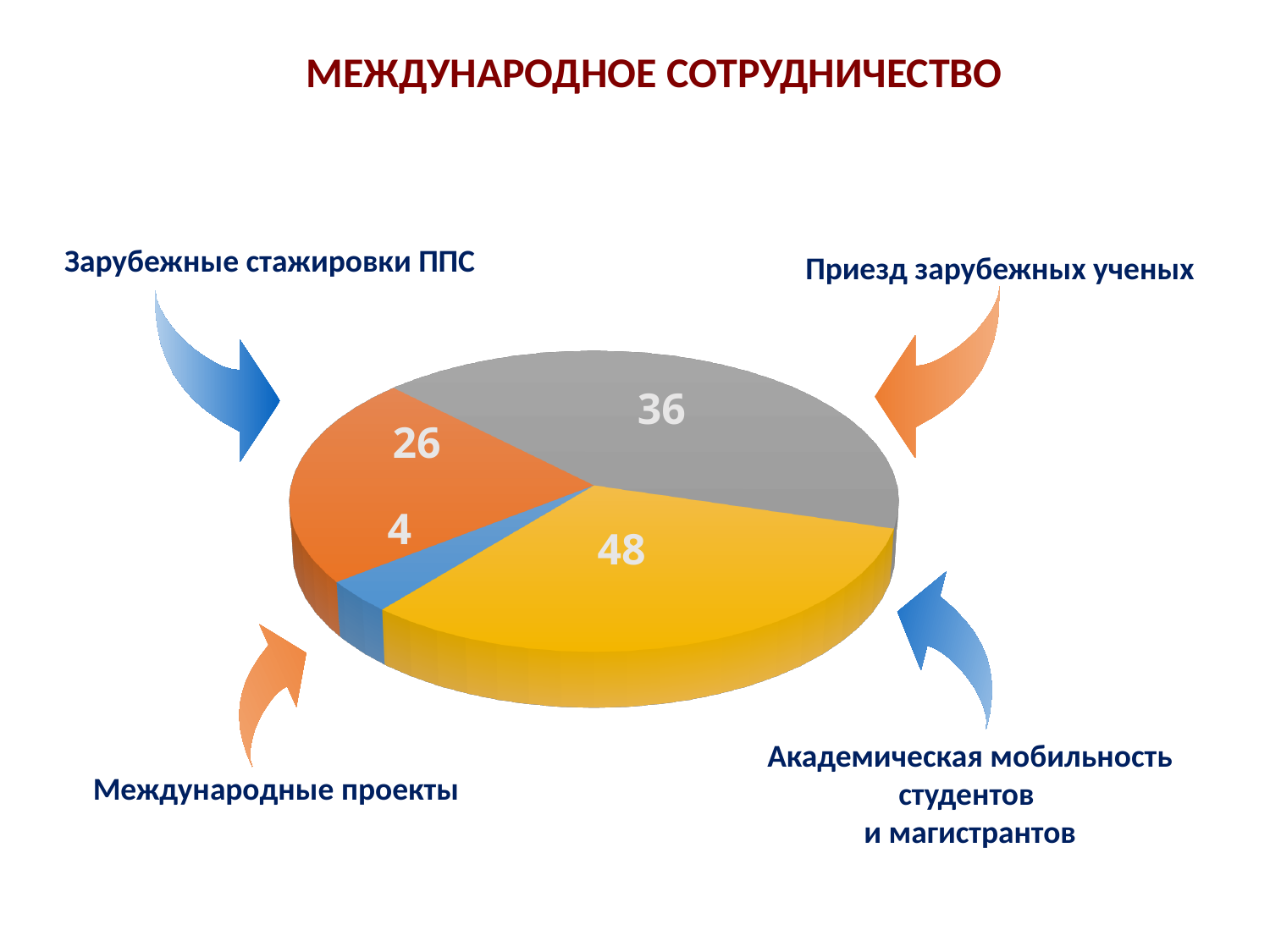
What is the value of the slice for Зарубежные стажировки ППС? 26 How many slices does the pie chart have? 4 What is the title of the slide containing the pie chart? МЕЖДУНАРОДНОЕ СОТРУДНИЧЕСТВО What kind of chart is shown on the slide? Pie chart Which is larger: the value for Зарубежные стажировки ППС or the value for Приезд зарубежных ученых? Приезд зарубежных ученых Which category has the smallest slice of the pie? Международные проекты What is the value of the slice for Международные проекты? 4 What is the value of the slice for Приезд зарубежных ученых? 36 What is the value of the slice for Академическая мобильность студентов и магистрантов? 48 What is the total of all the slice values in the pie chart? 114 What is the difference between the values for Академическая мобильность студентов и магистрантов and Приезд зарубежных ученых? 12 Which category has the largest slice of the pie? Академическая мобильность студентов и магистрантов